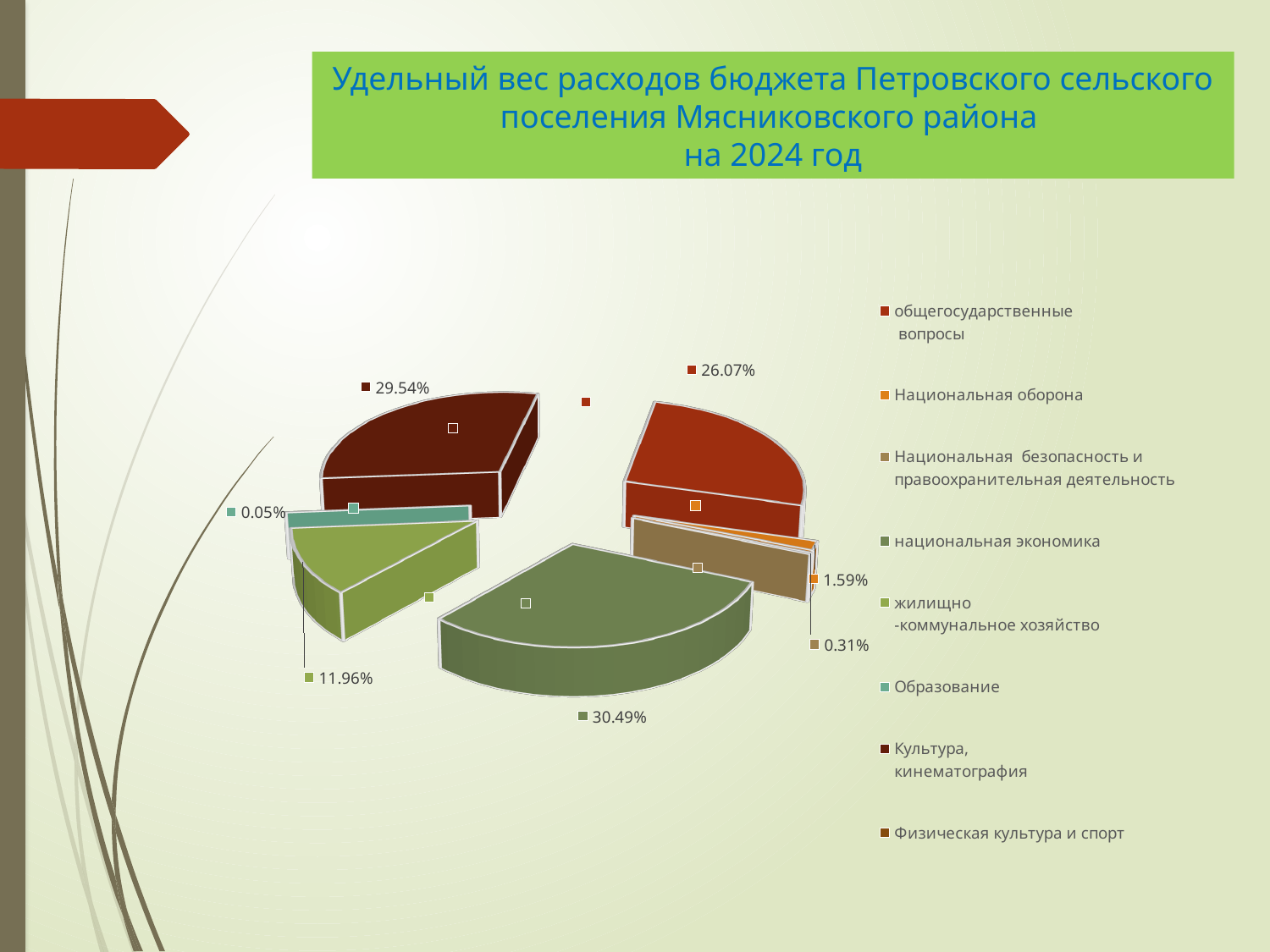
What share of the budget expenditure is for Образование? 0.05% What share of the budget expenditure is for Культура, кинематография? 29.54% Which category has the largest share of the budget expenditure? национальная экономика Which is larger: the share for общегосударственные вопросы or the share for жилищно-коммунальное хозяйство? общегосударственные вопросы What is the difference between the shares for национальная экономика and Культура, кинематография? 0.95% What share of the budget expenditure is for национальная экономика? 30.49% What share of the budget expenditure is for жилищно-коммунальное хозяйство? 11.96% What share of the budget expenditure is for Национальная оборона? 1.59% What share of the budget expenditure is for общегосударственные вопросы? 26.07% How many categories does the legend list? 8 What kind of chart is shown on the slide? pie chart